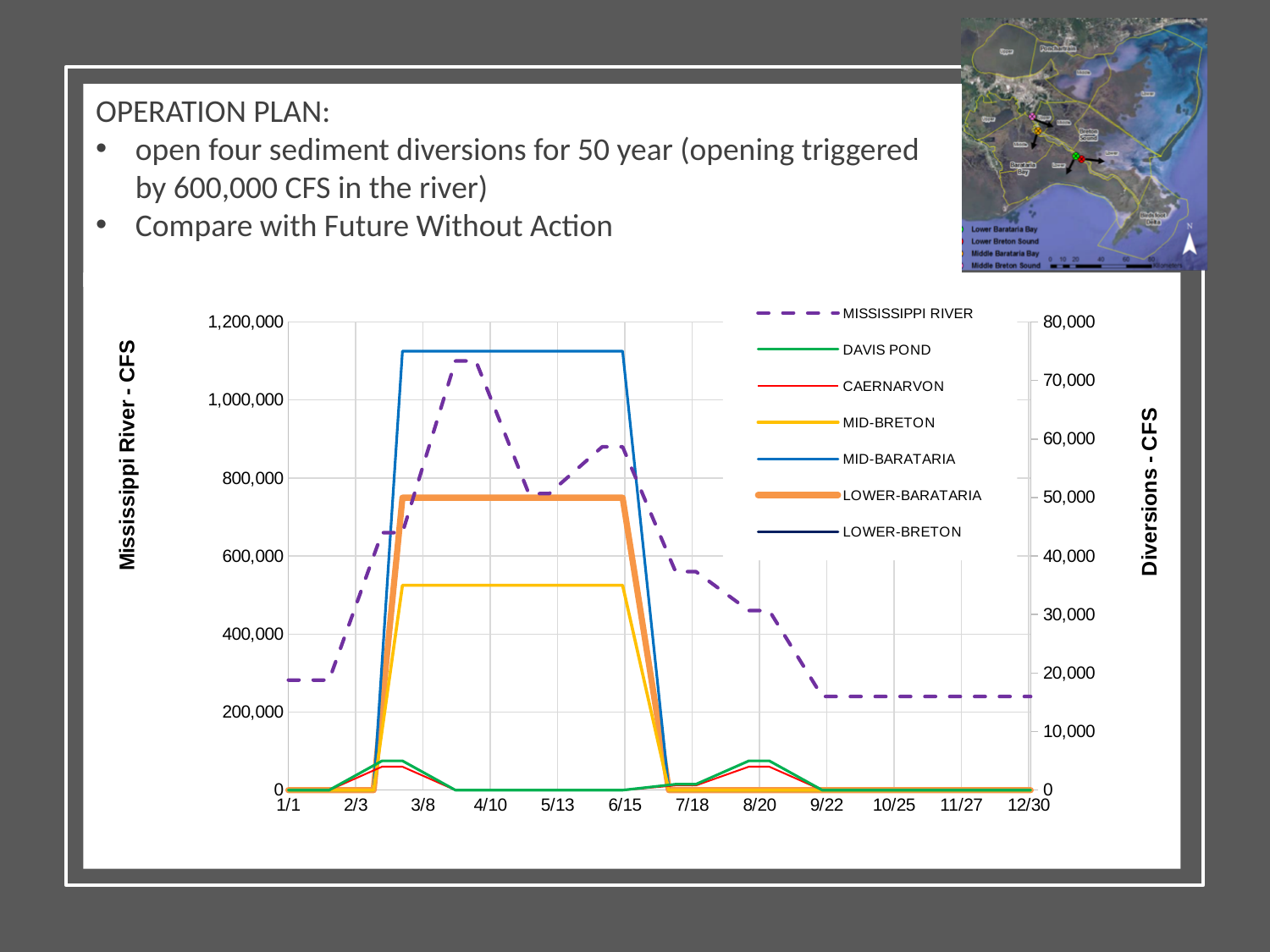
How many date labels are shown on the x axis? 12 Is the plateau value of the MID-BRETON series greater or less than 40,000 on the right axis? less Is the peak value of the MISSISSIPPI RIVER series greater or less than 1,000,000? greater What kind of chart is shown on the slide? line chart How many series does the legend list? 7 Which diversion series reaches the highest value on the right axis? MID-BARATARIA Which has the higher plateau value, LOWER-BARATARIA or MID-BRETON? LOWER-BARATARIA Is the MISSISSIPPI RIVER value at 1/1 greater or less than 400,000? less Which series is drawn with a dashed line? MISSISSIPPI RIVER What is the title of the left vertical axis? Mississippi River - CFS Does the MISSISSIPPI RIVER series rise or fall between 7/18 and 12/30? fall